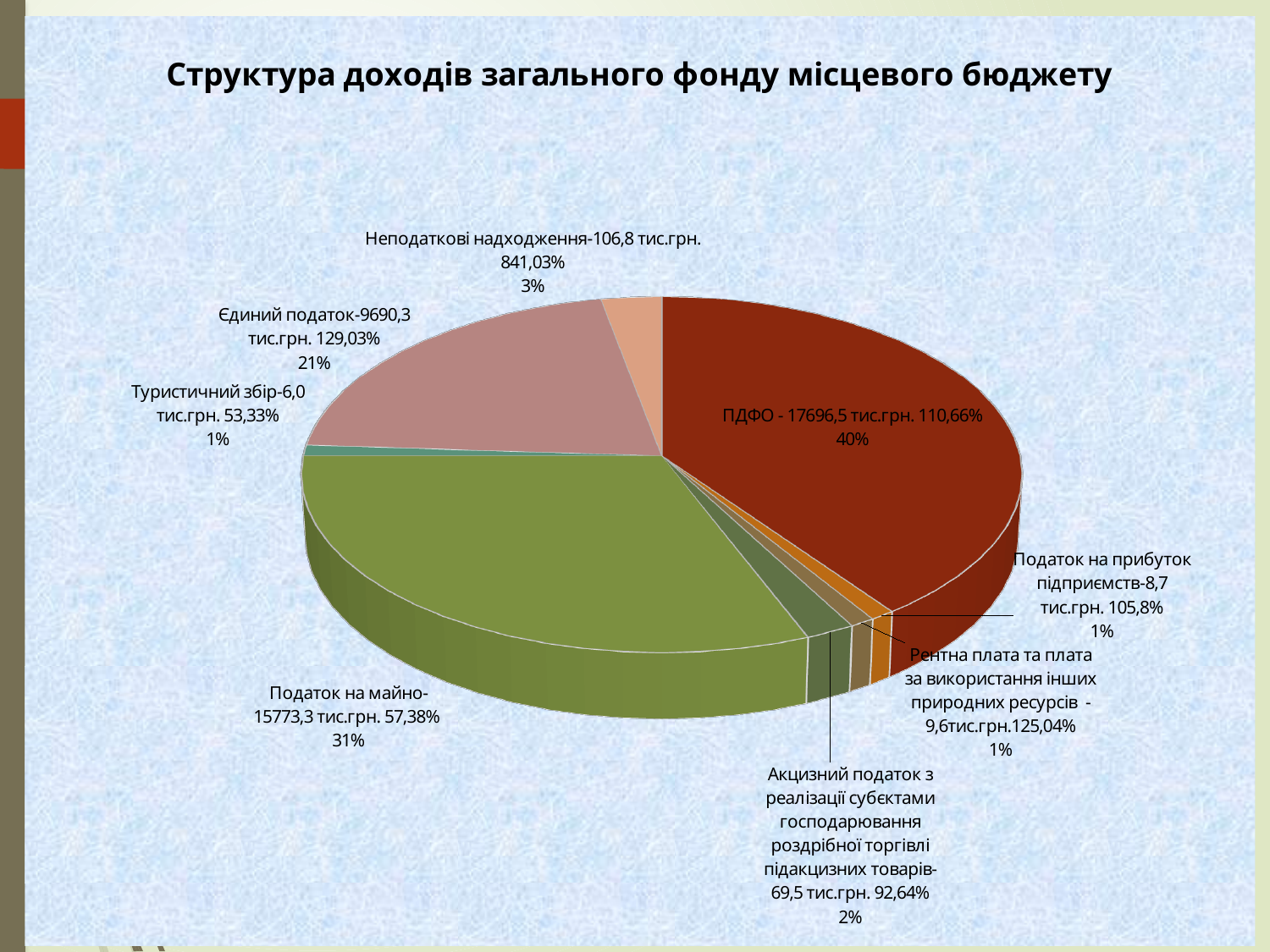
What share of the pie does Податок на майно account for? 31% What share of the pie does Єдиний податок account for? 21% What amount in тис.грн. is shown for Єдиний податок? 9690,3 тис.грн. What share of the pie does ПДФО account for? 40% How many slices does the pie chart have? 8 What amount in тис.грн. is shown for Податок на майно? 15773,3 тис.грн. Which is larger, the share for Єдиний податок or the share for Неподаткові надходження? Єдиний податок Which category has the largest slice of the pie? ПДФО What kind of chart is shown on the slide? pie chart What is the title of the chart? Структура доходів загального фонду місцевого бюджету What is the difference in percentage points between the share for ПДФО and the share for Податок на майно? 9 percentage points